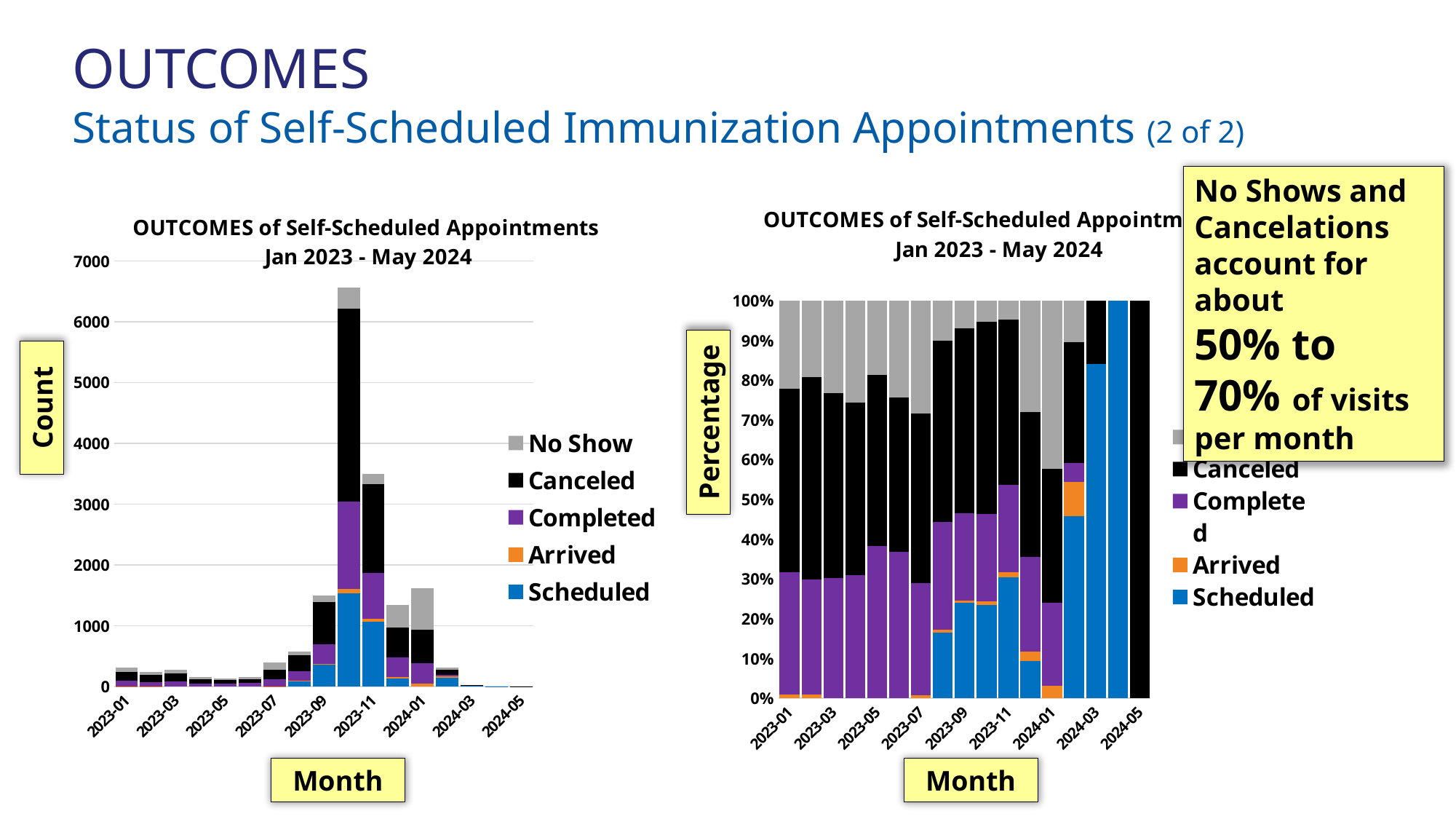
What is the label on the vertical axis of the right chart? Percentage In the right chart (Percentage axis), which outcome makes up the entire bar for 2024-05? Canceled How many monthly bars are plotted in the left chart (Count axis)? 17 In the left chart (Count axis), is the total for the tallest bar greater or less than 6000? greater In the right chart (Percentage axis), is the Completed share for 2023-01 greater or less than 20%? greater In the left chart (Count axis), is the total for 2023-01 greater or less than 1000? less What kind of chart is the left chart, 'OUTCOMES of Self-Scheduled Appointments Jan 2023 - May 2024' with the Count axis? Stacked bar chart In the left chart (Count axis), do the monthly totals rise or fall from 2023-11 to 2024-05? Fall How many series does the legend of the left chart (Count axis) list? 5 In the left chart (Count axis), which has the larger total, 2023-11 or 2024-01? 2023-11